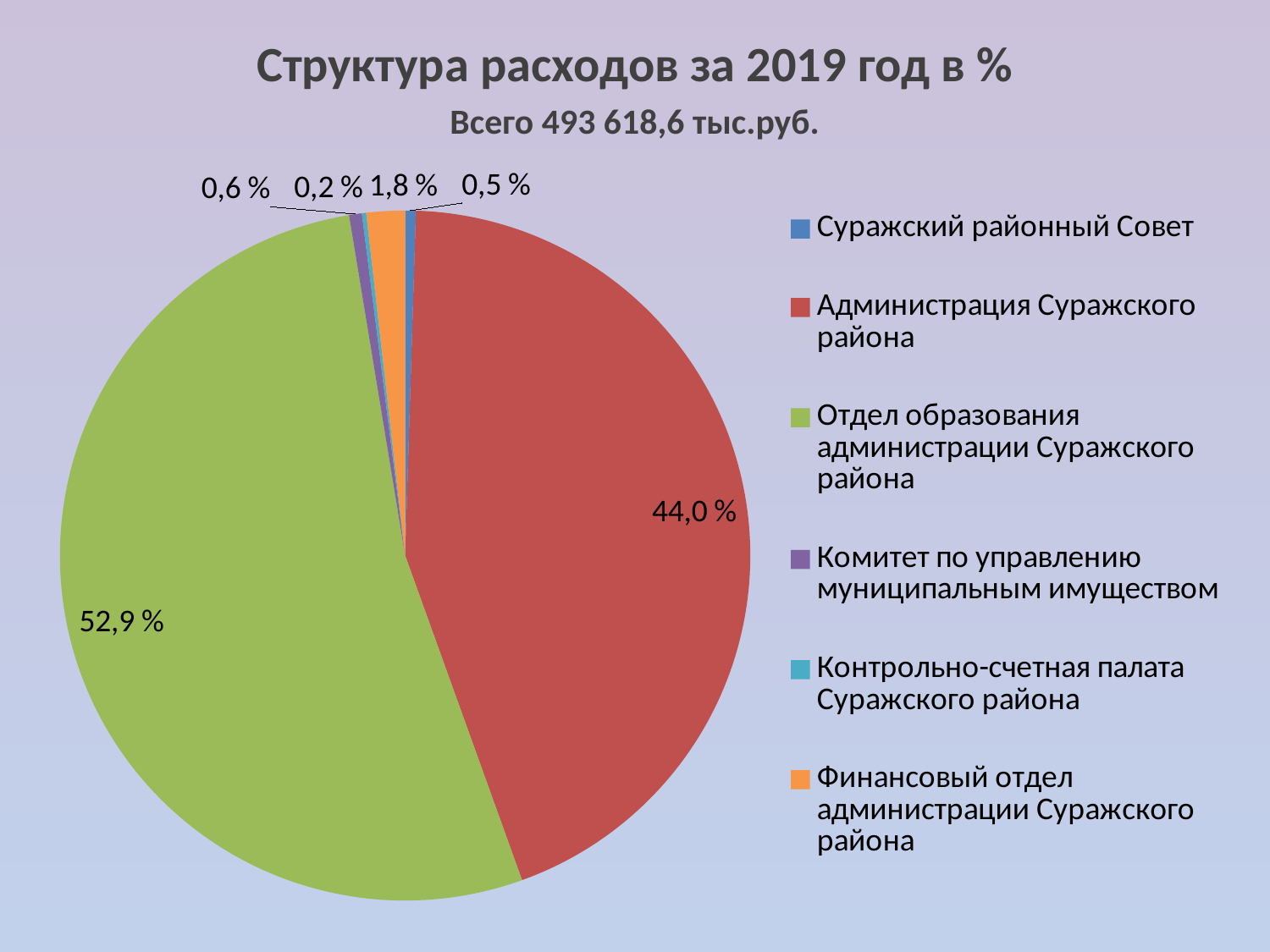
What share of expenditure does Суражский районный Совет account for? 0,5 % What is the difference in percentage points between the shares of Отдел образования администрации Суражского района and Администрация Суражского района? 8,9 What type of chart is shown on the slide? Pie chart What share of expenditure does Финансовый отдел администрации Суражского района account for? 1,8 % What share of expenditure does Отдел образования администрации Суражского района account for? 52,9 % What share of expenditure does Администрация Суражского района account for? 44,0 % Which has a larger share: Комитет по управлению муниципальным имуществом or Финансовый отдел администрации Суражского района? Финансовый отдел администрации Суражского района What share of expenditure does Контрольно-счетная палата Суражского района account for? 0,2 % Which category has the smallest share of expenditure? Контрольно-счетная палата Суражского района How many categories does the legend list? 6 Which category has the largest share of expenditure? Отдел образования администрации Суражского района What total amount of expenditure is stated in the chart subtitle? 493 618,6 тыс.руб.